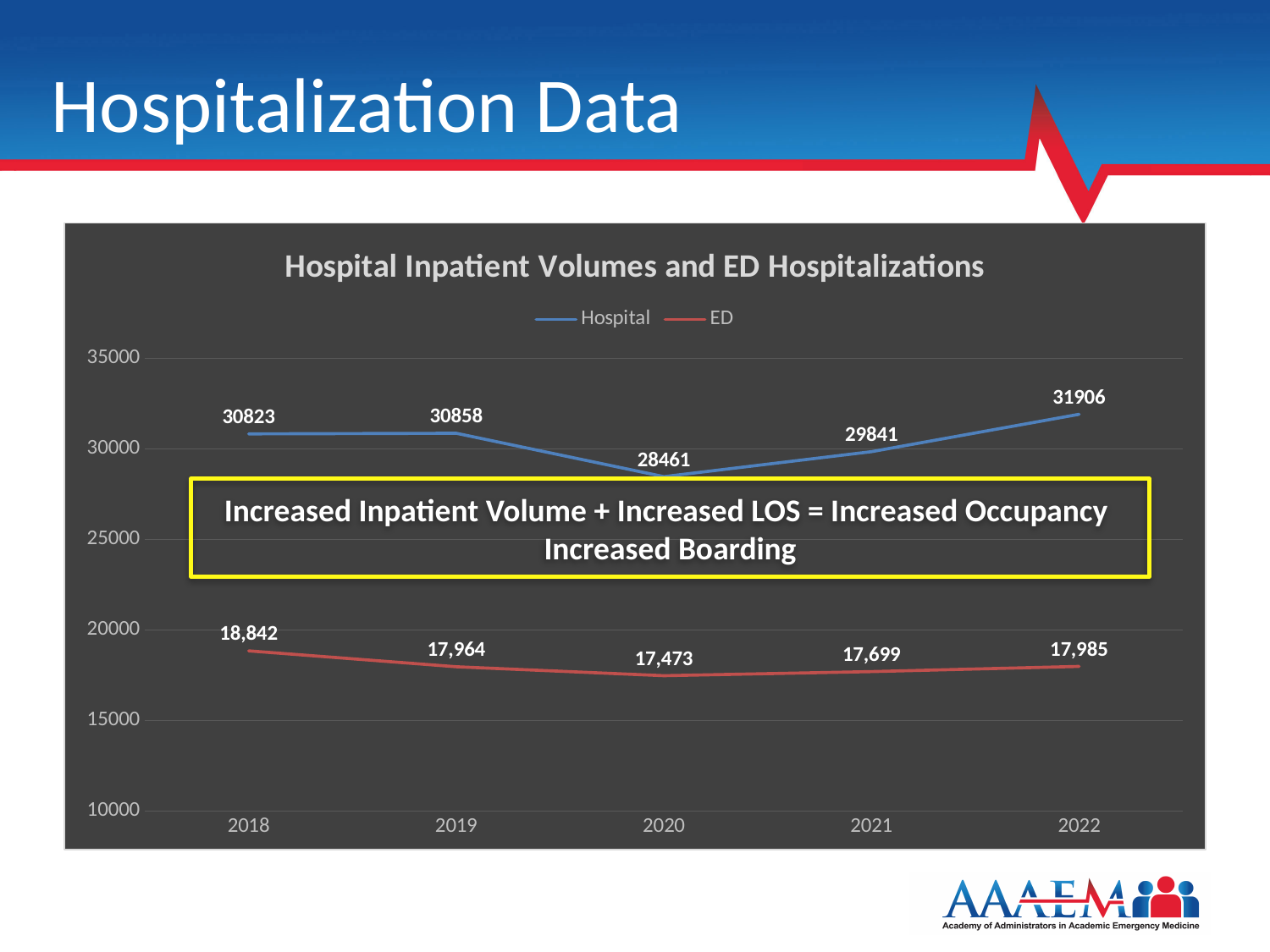
What is the difference between the ED values for 2018 and 2019? 878 How many series does the legend list? 2 What is the ED value for 2020? 17,473 Which is larger, the ED value for 2018 or the ED value for 2022? 2018 What is the Hospital value for 2020? 28461 How many years are shown on the x axis? 5 What is the difference between the Hospital values for 2022 and 2021? 2065 What is the Hospital value for 2022? 31906 What kind of chart is shown? line chart Which year has the lowest ED value? 2020 Is the Hospital value for 2020 greater or less than 30000? less Which year has the highest Hospital value? 2022